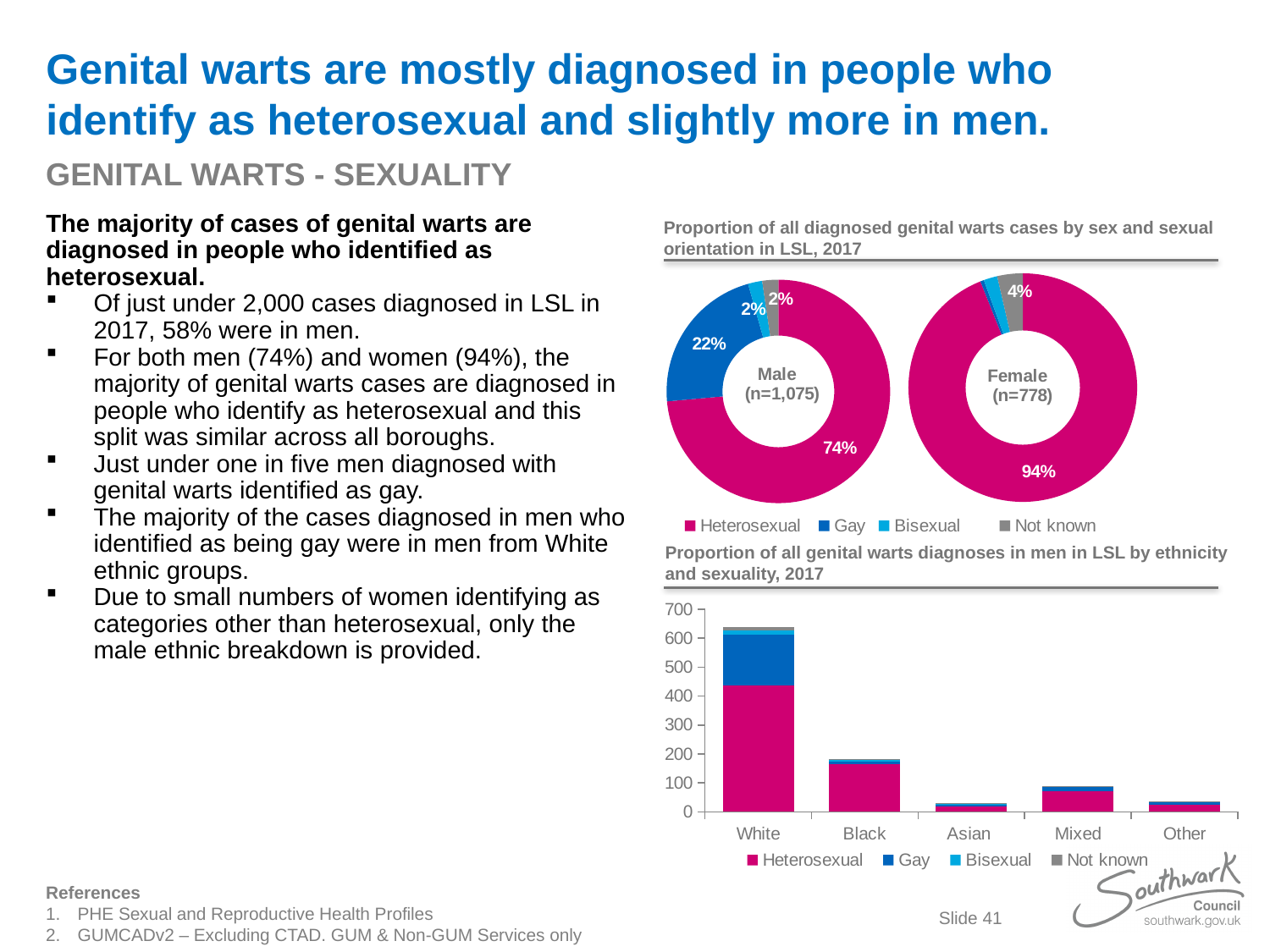
In the donut chart 'Proportion of all diagnosed genital warts cases by sex and sexual orientation in LSL, 2017', what percentage of male cases identified as gay? 22% How many ethnic group categories are shown on the x axis of the chart 'Proportion of all genital warts diagnoses in men in LSL by ethnicity and sexuality, 2017'? 5 How many series does the legend of the donut chart 'Proportion of all diagnosed genital warts cases by sex and sexual orientation in LSL, 2017' list? 4 In the donut chart 'Proportion of all diagnosed genital warts cases by sex and sexual orientation in LSL, 2017', what percentage of male cases identified as heterosexual? 74% In the chart 'Proportion of all genital warts diagnoses in men in LSL by ethnicity and sexuality, 2017', which ethnic group has the highest total? White In the chart 'Proportion of all genital warts diagnoses in men in LSL by ethnicity and sexuality, 2017', is the total for White greater or less than 600? greater In the donut chart 'Proportion of all diagnosed genital warts cases by sex and sexual orientation in LSL, 2017', what percentage of female cases had sexual orientation not known? 4% In the donut chart 'Proportion of all diagnosed genital warts cases by sex and sexual orientation in LSL, 2017', which sex has the larger heterosexual share? Female In the donut chart 'Proportion of all diagnosed genital warts cases by sex and sexual orientation in LSL, 2017', how many cases does the Male donut represent (n)? 1,075 What kind of chart is 'Proportion of all genital warts diagnoses in men in LSL by ethnicity and sexuality, 2017'? Stacked bar chart In the donut chart 'Proportion of all diagnosed genital warts cases by sex and sexual orientation in LSL, 2017', what is the difference between the heterosexual share for females and for males? 20 percentage points In the donut chart 'Proportion of all diagnosed genital warts cases by sex and sexual orientation in LSL, 2017', what percentage of female cases identified as heterosexual? 94%